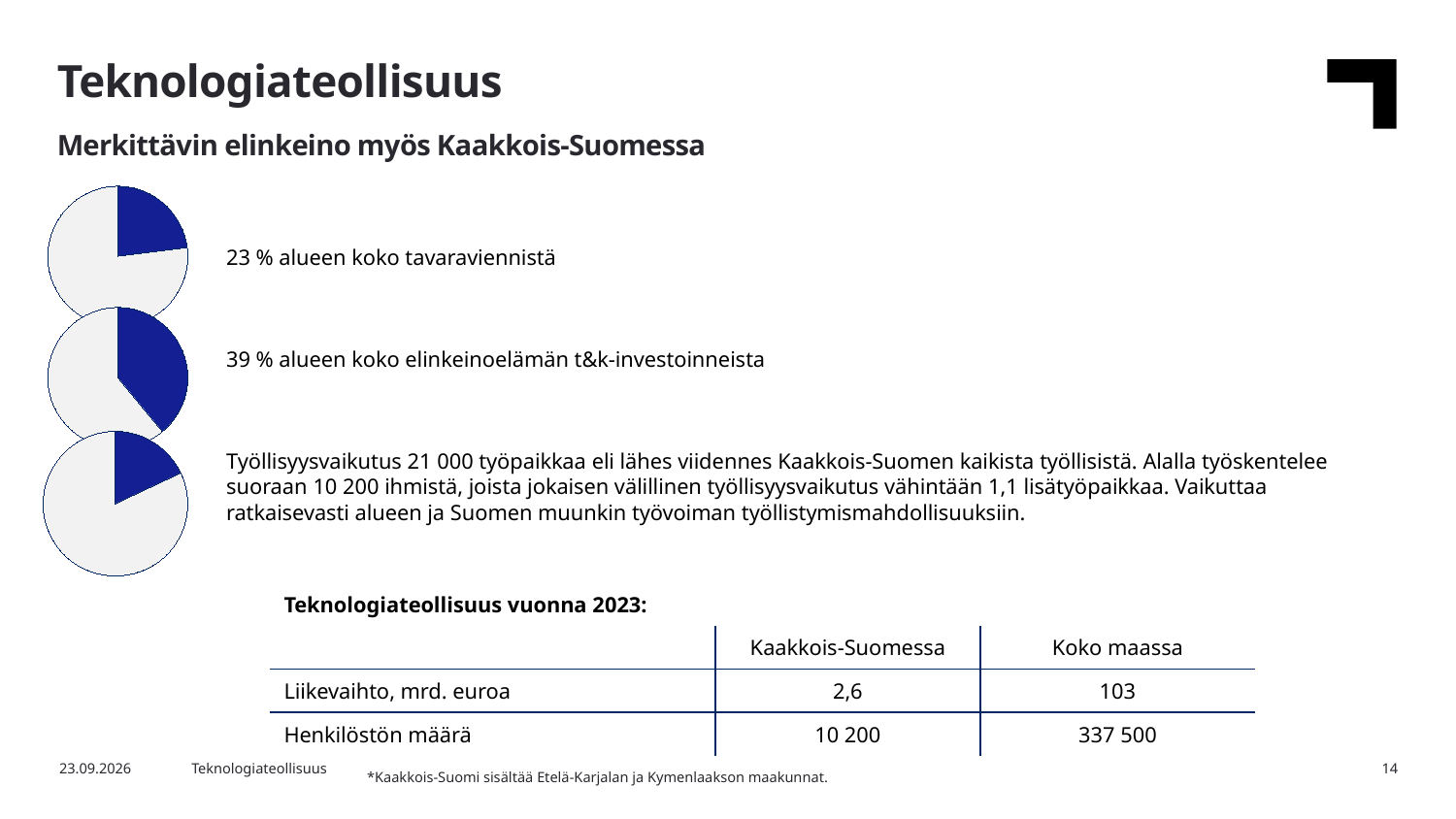
Which pie chart has the larger highlighted slice, the top one or the middle one? The middle one How many pie charts are on the slide? 3 Is the highlighted slice in the middle pie chart greater or less than 50 %? less What does the highlighted slice of the top pie chart represent? Share of the region's total goods exports (alueen koko tavaraviennistä) Is the highlighted slice in the bottom pie chart greater or less than 25 %? less What colour is the highlighted slice in the pie charts? Dark blue In the top pie chart, what share does the highlighted (blue) slice represent? 23 % How many slices does each pie chart have? 2 What kind of charts are shown on the left side of the slide? Pie charts In the middle pie chart, what share does the highlighted (blue) slice represent? 39 % Which of the three pie charts has the largest highlighted slice? The middle one